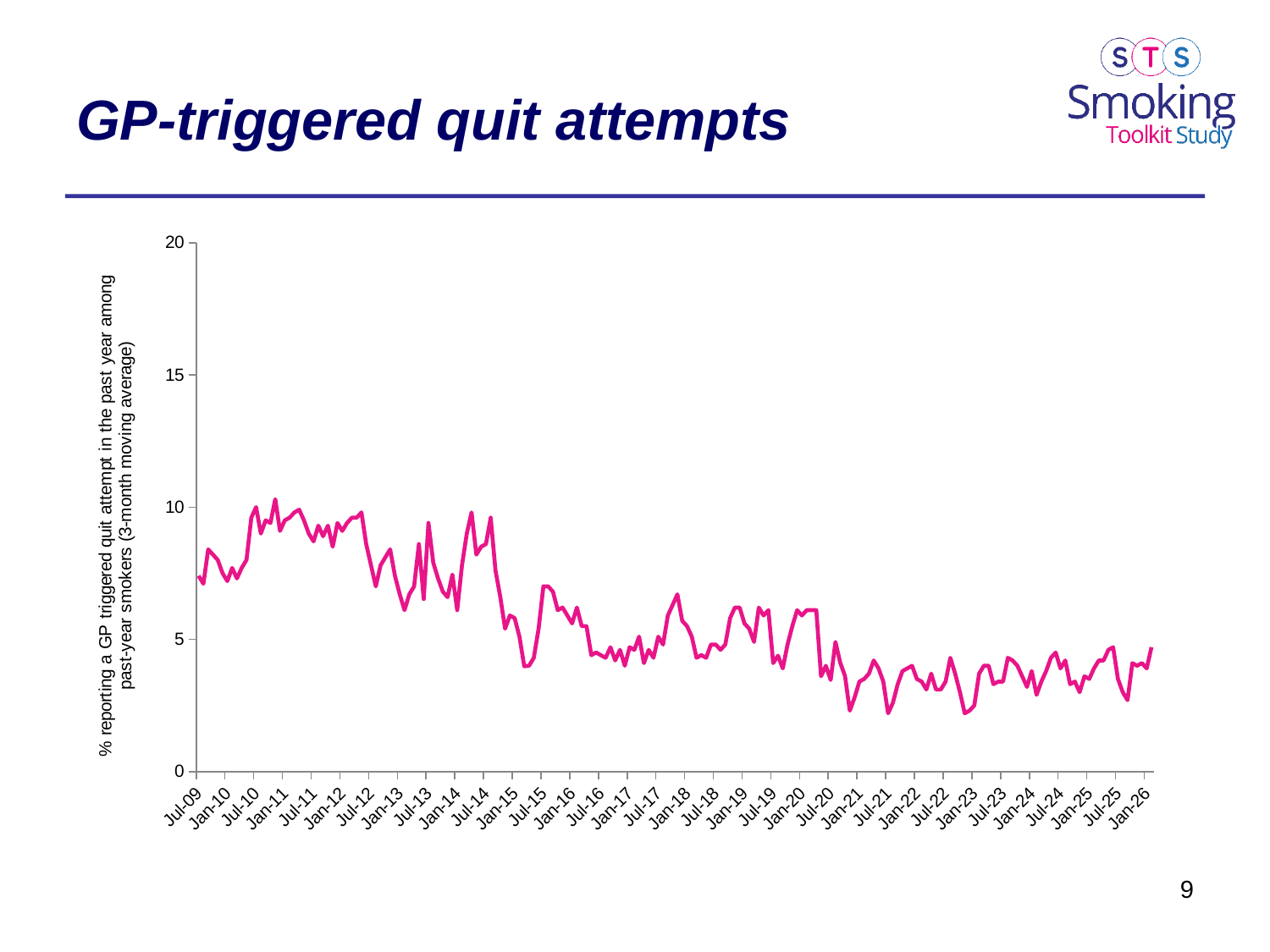
Overall, do the values rise or fall from Jul-09 to Jan-26? fall How many lines are plotted on the chart? 1 Is the value at Jan-11 greater or less than 5? greater Is the value at Jan-21 greater or less than 5? less How many date labels are shown on the x-axis? 34 Is the value at Jan-23 greater or less than 5? less What does the y-axis of the chart measure? % reporting a GP triggered quit attempt in the past year among past-year smokers (3-month moving average) What is the title of the slide's chart? GP-triggered quit attempts What kind of chart is shown on the slide? line chart